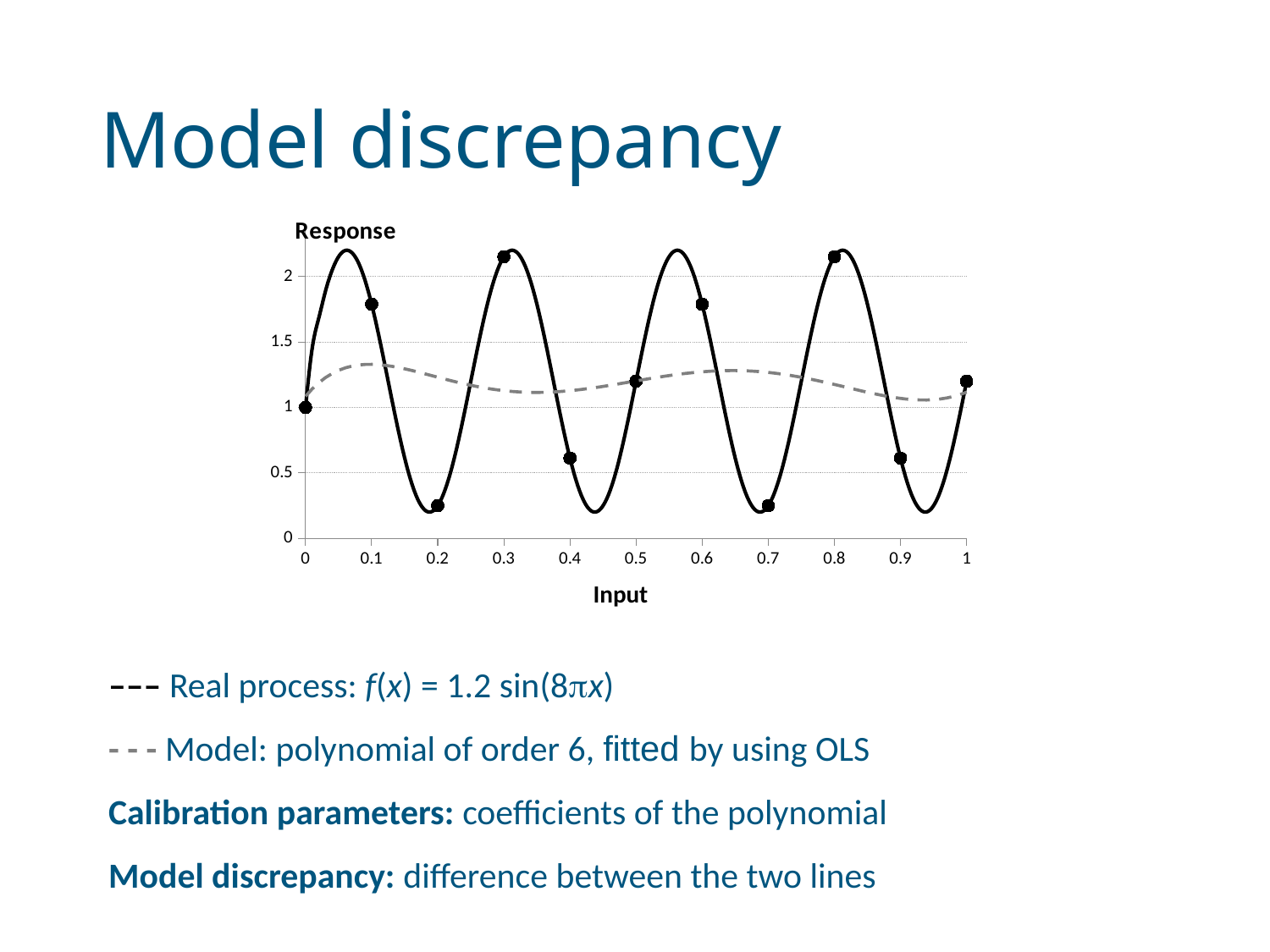
Is the value of the solid black line at Input 0.2 greater or less than 0.5? less Is the value of the dashed grey line at Input 0.9 greater or less than 1.5? less Does the solid black line rise or fall between Input 0 and Input 0.1? rise Which is larger: the value of the solid black line at Input 0.3 or at Input 0.2? Input 0.3 Is the value of the solid black line at Input 0.3 greater or less than 2? greater What is the title of the vertical axis? Response How many black data points are plotted on the chart? 11 What is the title of the horizontal axis? Input What kind of chart is shown on the slide? line chart